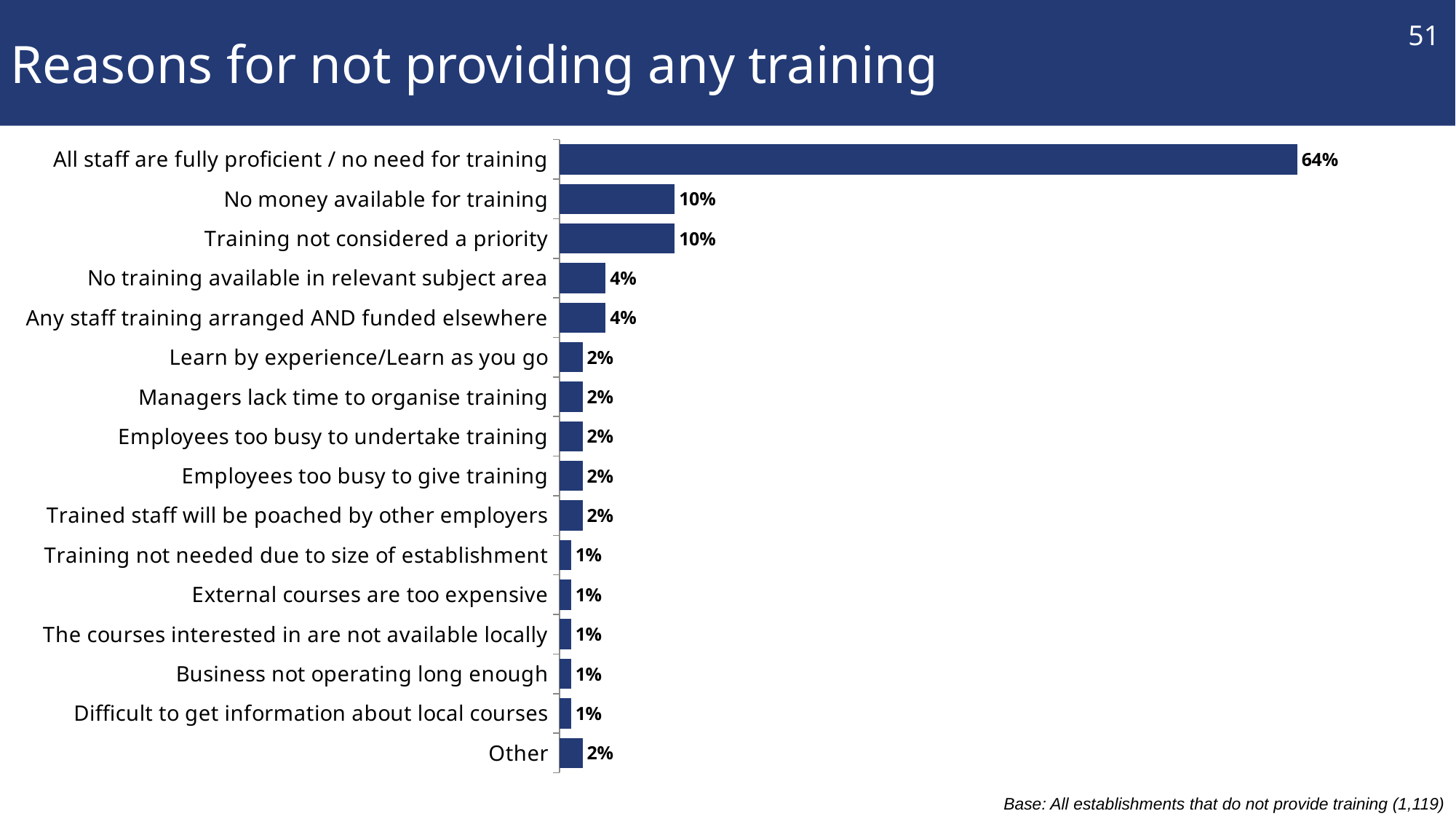
Which reason has the highest percentage? All staff are fully proficient / no need for training How many reasons (categories) are shown in the chart? 16 What percentage is shown for 'All staff are fully proficient / no need for training'? 64% What percentage is shown for 'No training available in relevant subject area'? 4% What type of chart is shown on the slide? Bar chart What is the value for 'No money available for training'? 10% What percentage is shown for 'Business not operating long enough'? 1% What is the base stated for the chart? All establishments that do not provide training (1,119) What is the difference between 'All staff are fully proficient / no need for training' and 'Training not considered a priority'? 54% What is the value for 'Trained staff will be poached by other employers'? 2% What is the difference between 'No money available for training' and 'Any staff training arranged AND funded elsewhere'? 6% Which is larger: 'Learn by experience/Learn as you go' or 'External courses are too expensive'? Learn by experience/Learn as you go